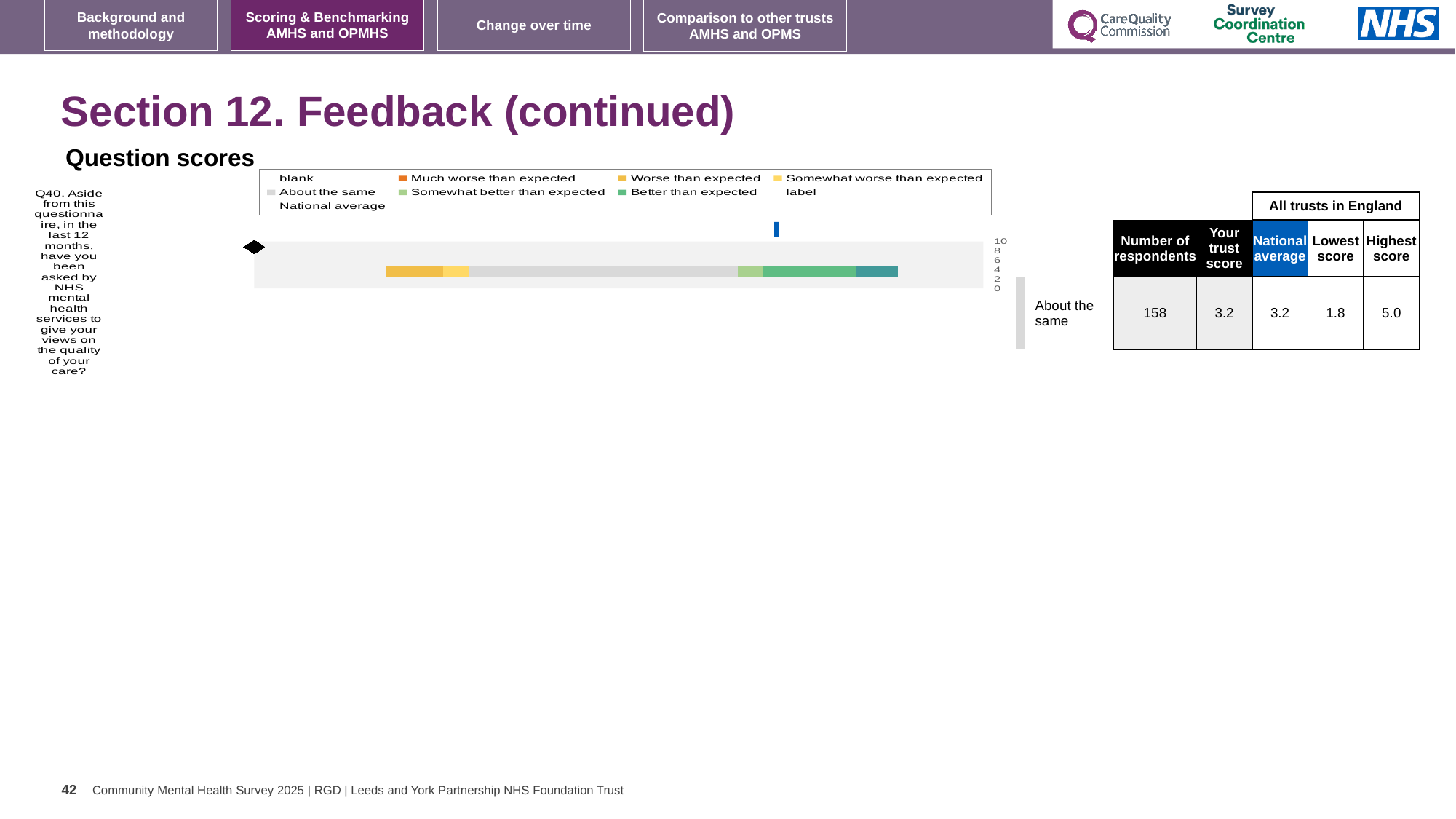
What benchmark category label is shown next to the Q40 bar? About the same In the table beside the chart, what is the highest score among all trusts in England for Q40? 5.0 What colour does the chart legend use for 'Much worse than expected'? orange In the table beside the chart, what is the difference between the highest score and the lowest score for Q40? 3.2 How many questions are plotted in the Question scores chart? 1 In the table beside the chart, which is larger for Q40: the highest score or the trust score? highest score Which question number is plotted in the Question scores chart? Q40 In the table beside the chart, what is the number of respondents for Q40? 158 In the table beside the chart, what is the lowest score among all trusts in England for Q40? 1.8 In the table beside the chart, what is the national average for Q40? 3.2 In the table beside the chart, what is 'Your trust score' for Q40? 3.2 What kind of chart is shown under 'Question scores'? bar chart